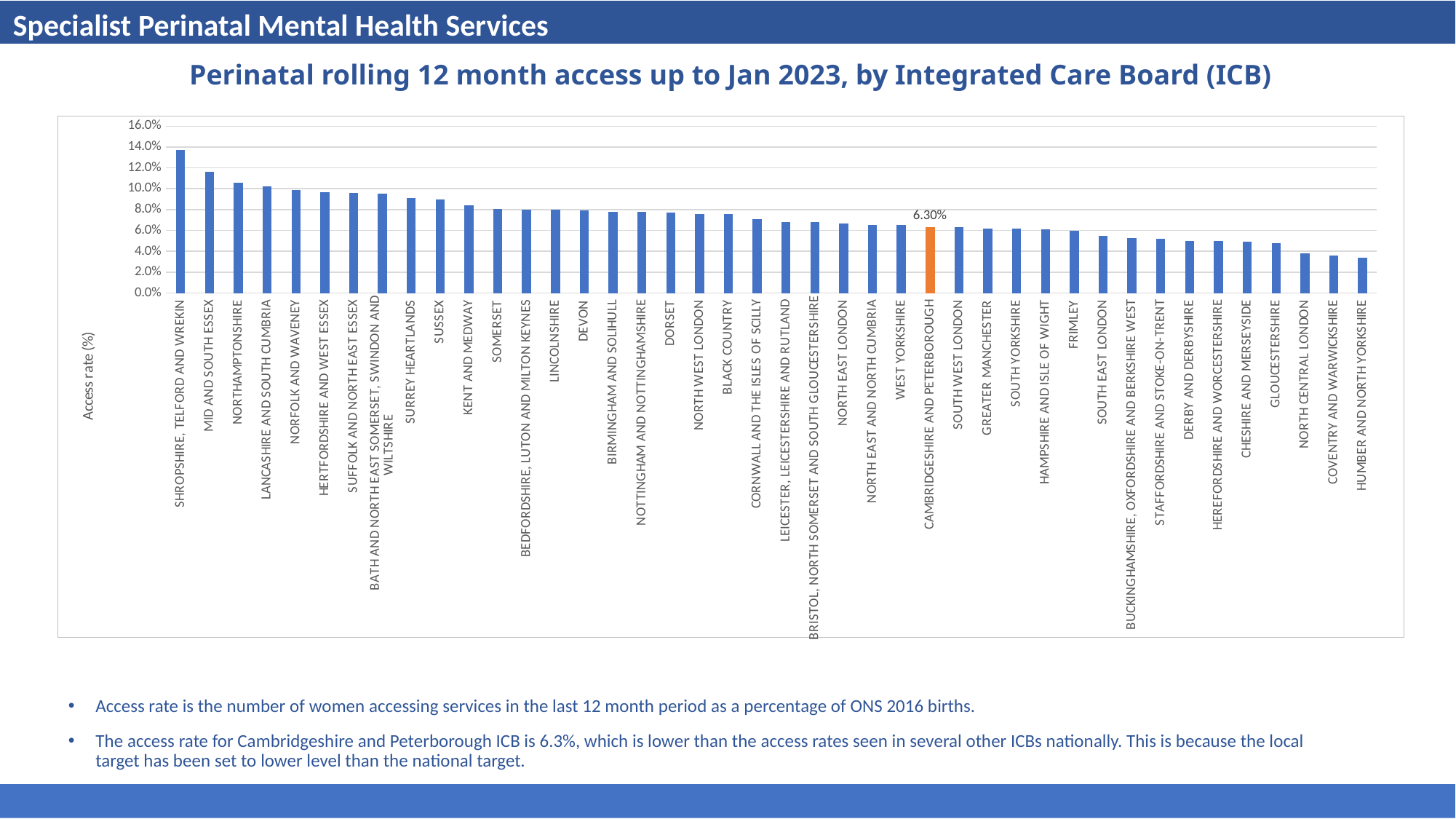
Which ICB's bar is highlighted in orange? Cambridgeshire and Peterborough Which has a higher access rate, Northamptonshire or Frimley? Northamptonshire What is the access rate shown for Cambridgeshire and Peterborough? 6.30% Is the access rate for Mid and South Essex greater or less than 10.0%? greater Is the access rate for Gloucestershire greater or less than 6.0%? less Is the access rate for Humber and North Yorkshire greater or less than 4.0%? less Which ICB has the lowest access rate? Humber and North Yorkshire What type of chart is shown on the slide? Bar chart Which has a higher access rate, Sussex or North Central London? Sussex Which ICB has the highest access rate? Shropshire, Telford and Wrekin How many ICBs are shown on the chart? 42